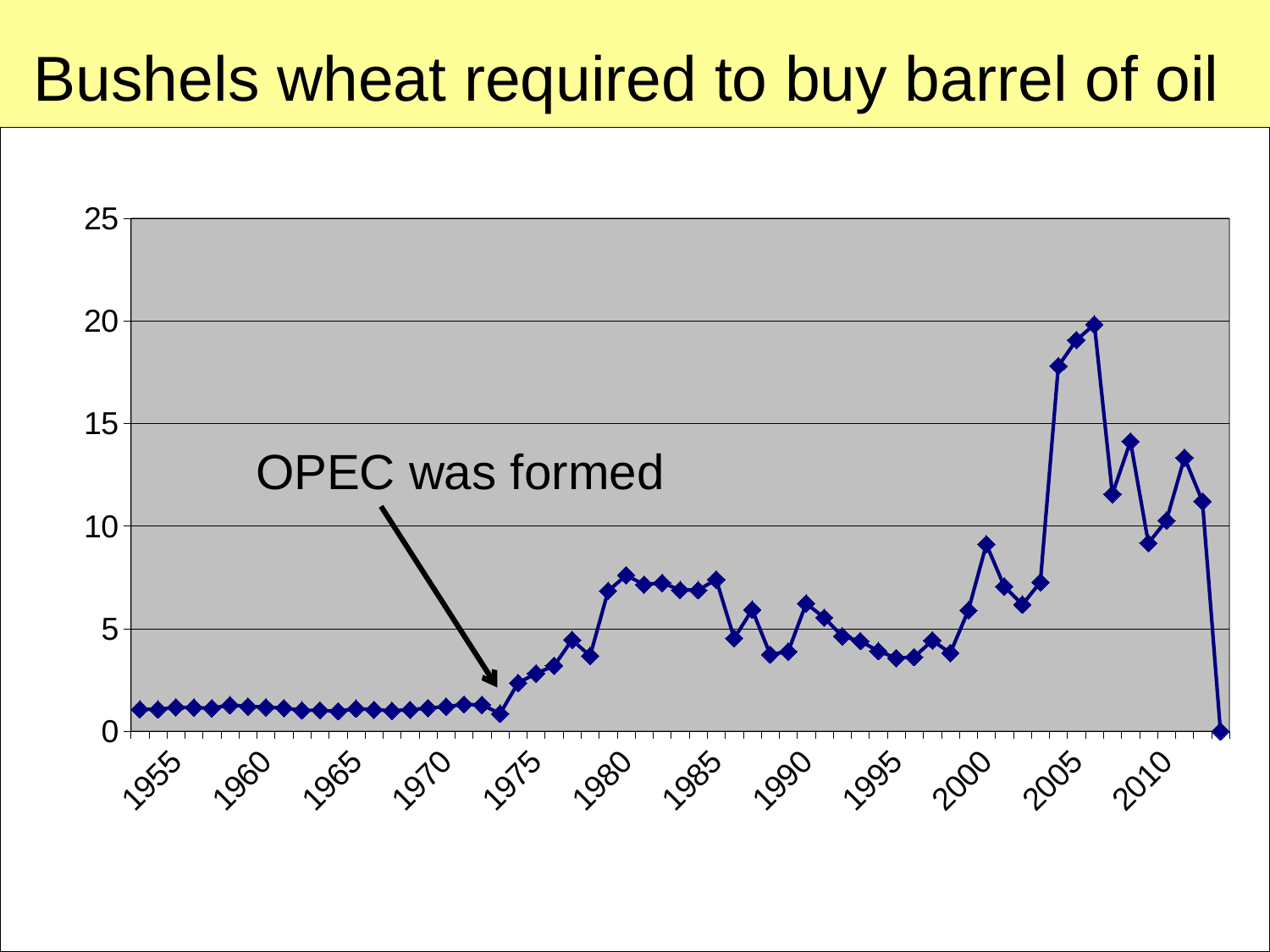
Is the value for 1995 greater or less than 5? less Is the value for 1975 greater or less than 5? less What event does the annotation with the arrow on the chart point out? OPEC was formed Which year has the larger value, 1960 or 1980? 1980 Is the value for 1955 greater or less than 5? less What kind of chart is shown on the slide? line chart Which year has the larger value, 1995 or 2005? 2005 Do the values rise or fall between 1995 and 2005? rise What is the title of the chart? Bushels wheat required to buy barrel of oil